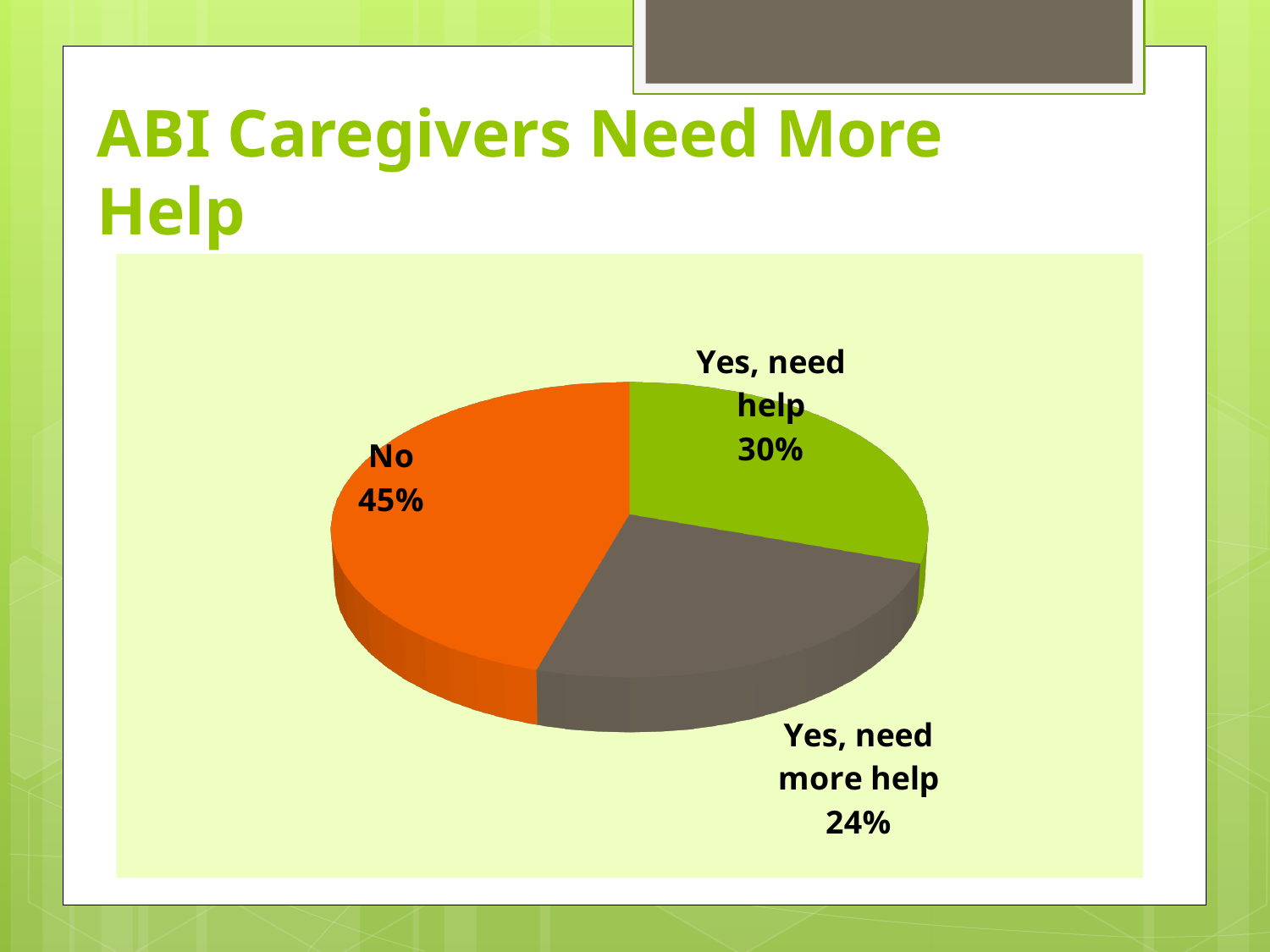
What kind of chart is shown on the slide? pie chart What is the difference in percentage points between the "Yes, need help" slice and the "Yes, need more help" slice? 6 What is the title of the slide containing the pie chart? ABI Caregivers Need More Help What is the difference in percentage points between the "No" slice and the "Yes, need help" slice? 15 What percentage of the pie is labelled "No"? 45% Which slice of the pie is the smallest? Yes, need more help What percentage of the pie is labelled "Yes, need more help"? 24% What colour is the "No" slice of the pie? orange Which is larger, the "Yes, need help" slice or the "Yes, need more help" slice? Yes, need help Which slice of the pie is the largest? No How many slices does the pie chart have? 3 What percentage of the pie is labelled "Yes, need help"? 30%